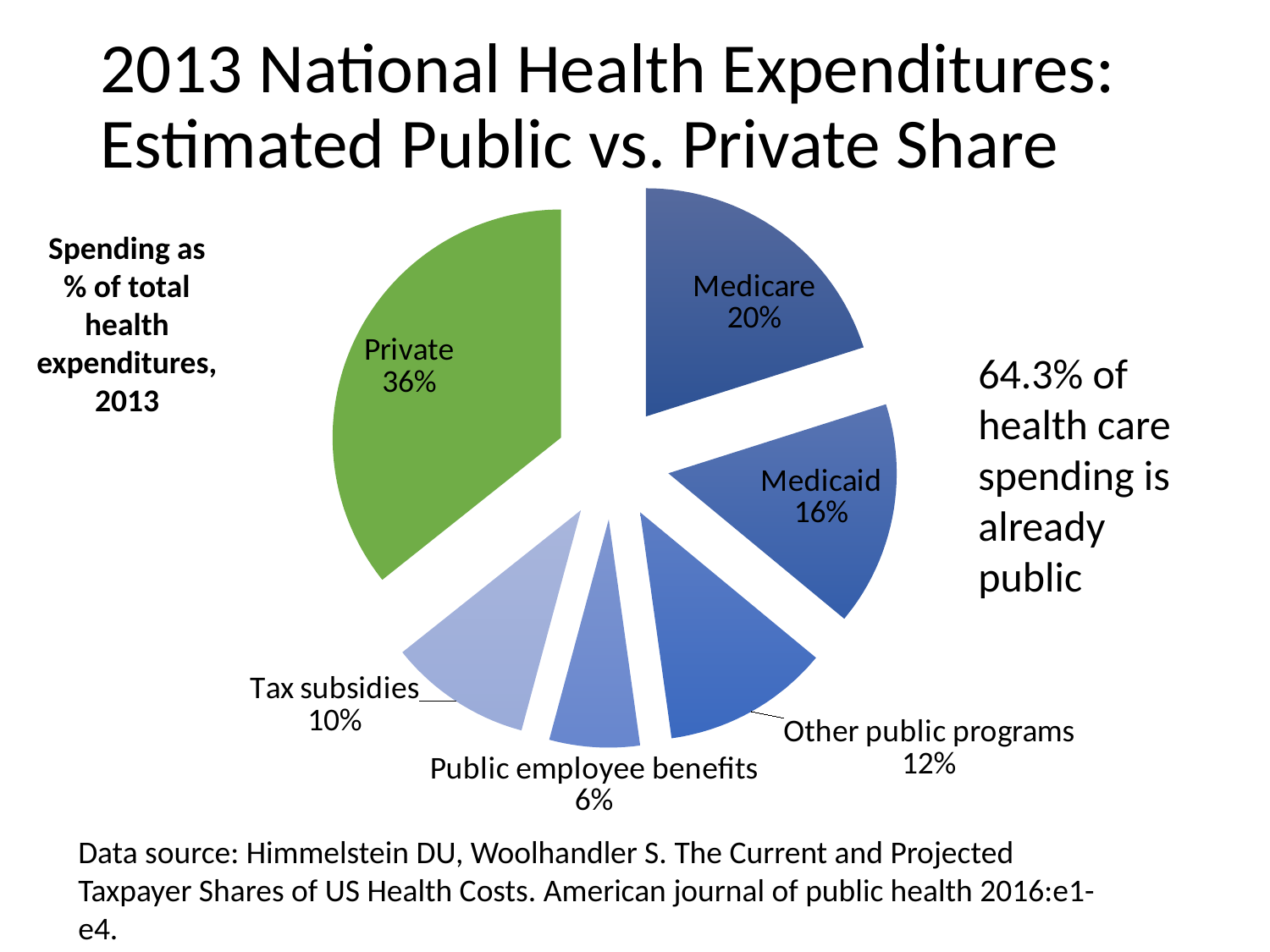
What share of total health expenditures is Medicare? 20% What is the difference in percentage points between the Medicare and Medicaid shares? 4 Which category has the smallest share of the pie? Public employee benefits Which is larger, the share for Tax subsidies or the share for Other public programs? Other public programs What colour is the Private slice of the pie? Green What share of total health expenditures is Private? 36% How many categories are shown in the pie chart? 6 What share of total health expenditures is Medicaid? 16% What kind of chart is shown on the slide? Pie chart What is the combined share of Medicare and Medicaid? 36% What share of total health expenditures is Public employee benefits? 6% Which category has the largest share of the pie? Private